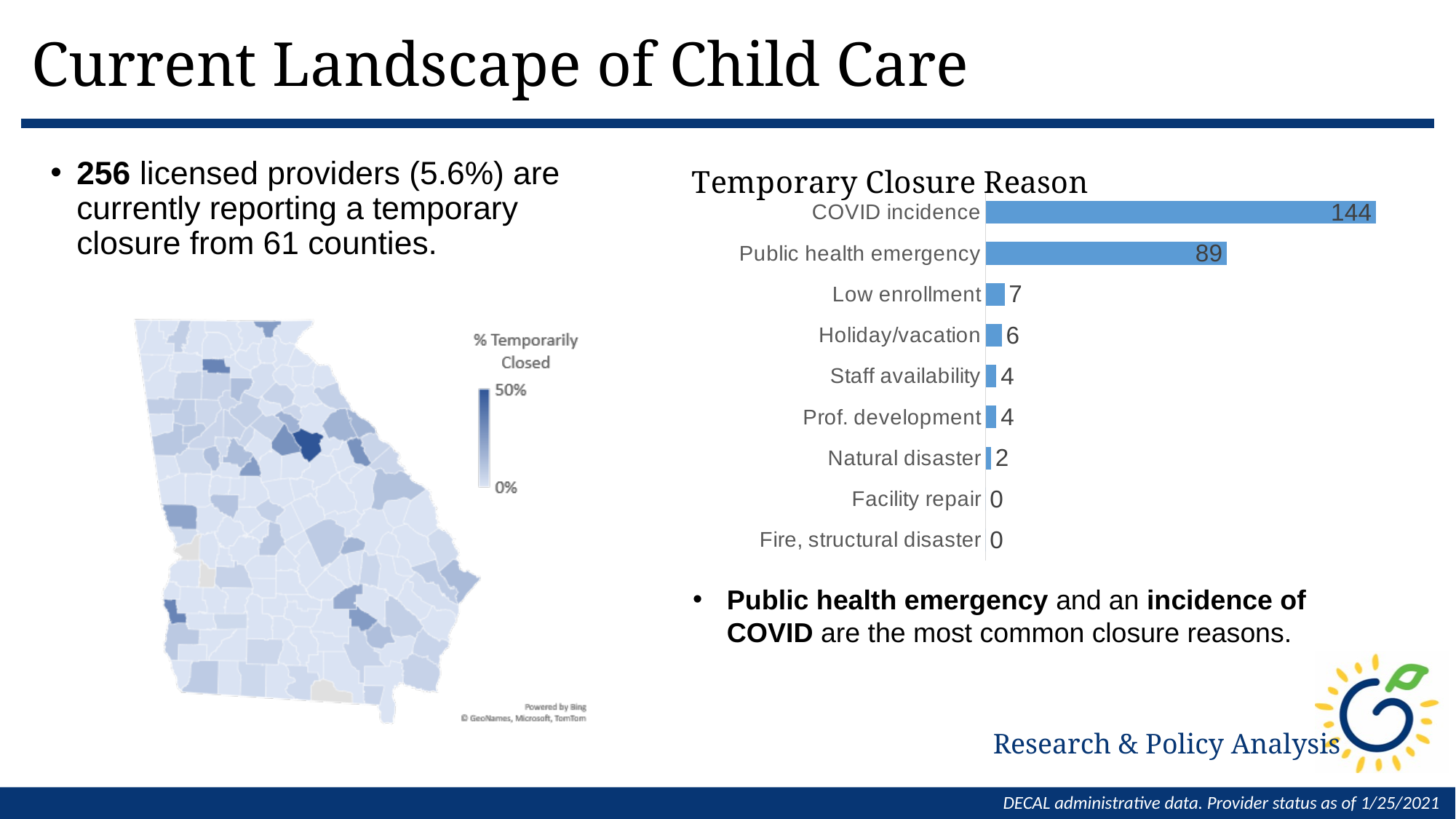
In the Temporary Closure Reason chart, what is the value for Public health emergency? 89 In the Temporary Closure Reason chart, what is the value for Holiday/vacation? 6 In the Temporary Closure Reason chart, which closure reasons have a value of 0? Facility repair and Fire, structural disaster What type of chart is the Temporary Closure Reason chart? Bar chart In the Temporary Closure Reason chart, what is the difference between COVID incidence and Public health emergency? 55 In the Temporary Closure Reason chart, what is the value for Natural disaster? 2 In the Temporary Closure Reason chart, which closure reason has the highest value? COVID incidence In the Temporary Closure Reason chart, what is the value for Low enrollment? 7 What is the title of the bar chart on the slide? Temporary Closure Reason How many closure reasons are listed in the Temporary Closure Reason chart? 9 In the Temporary Closure Reason chart, what is the value for COVID incidence? 144 In the Temporary Closure Reason chart, which is larger: Low enrollment or Holiday/vacation? Low enrollment